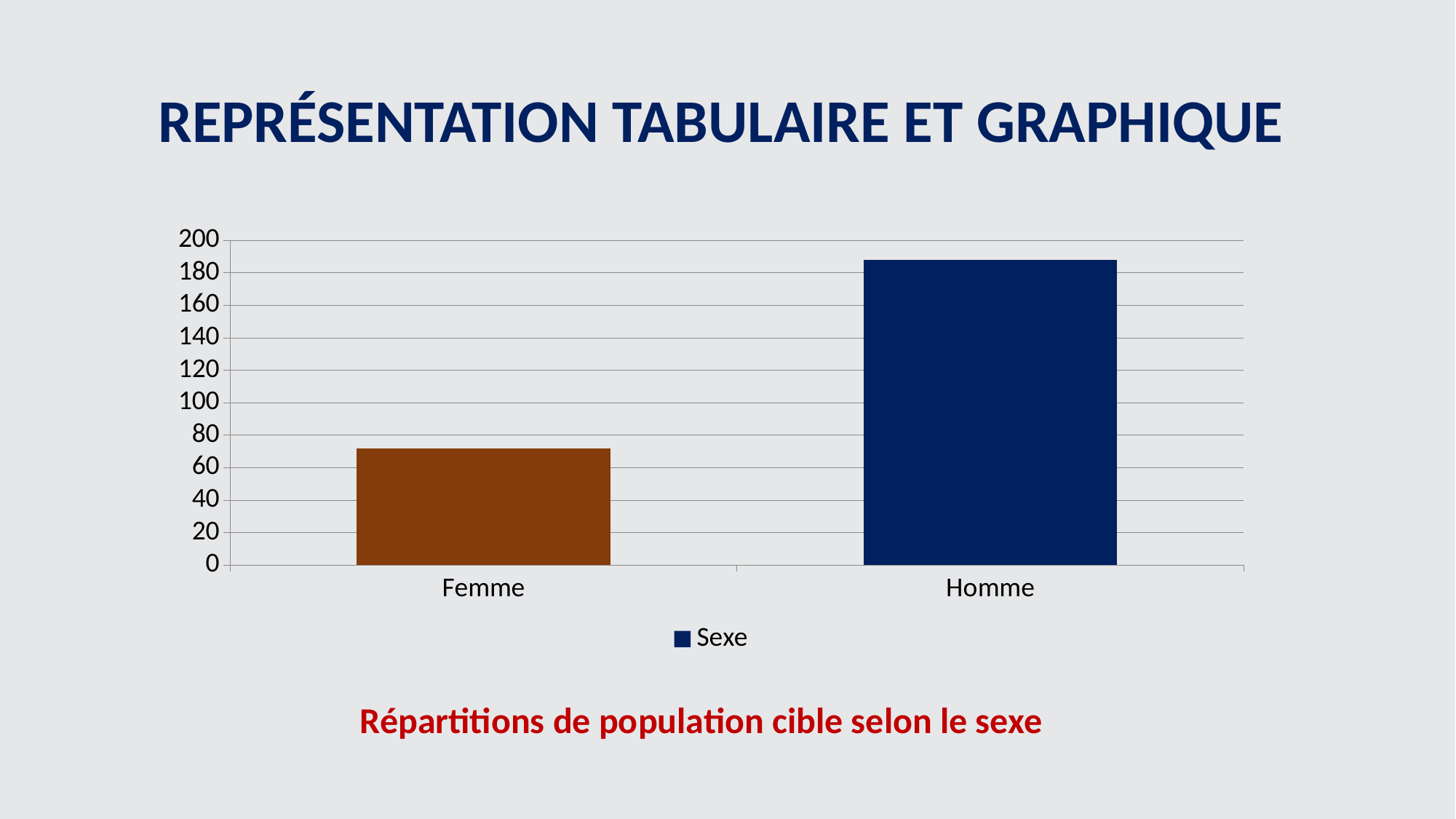
What is the name of the series listed in the chart legend? Sexe Is the value for Femme greater or less than 100? less Which category has the highest bar in the chart? Homme What is the caption shown in red below the chart? Répartitions de population cible selon le sexe What kind of chart is shown on the slide? bar chart How many categories are shown on the x axis of the chart? 2 Is the value for Homme greater or less than 180? greater How many series does the chart legend list? 1 Is the value for Femme greater or less than 60? greater Which category has the lowest bar in the chart? Femme Which is larger, the value for Femme or the value for Homme? Homme